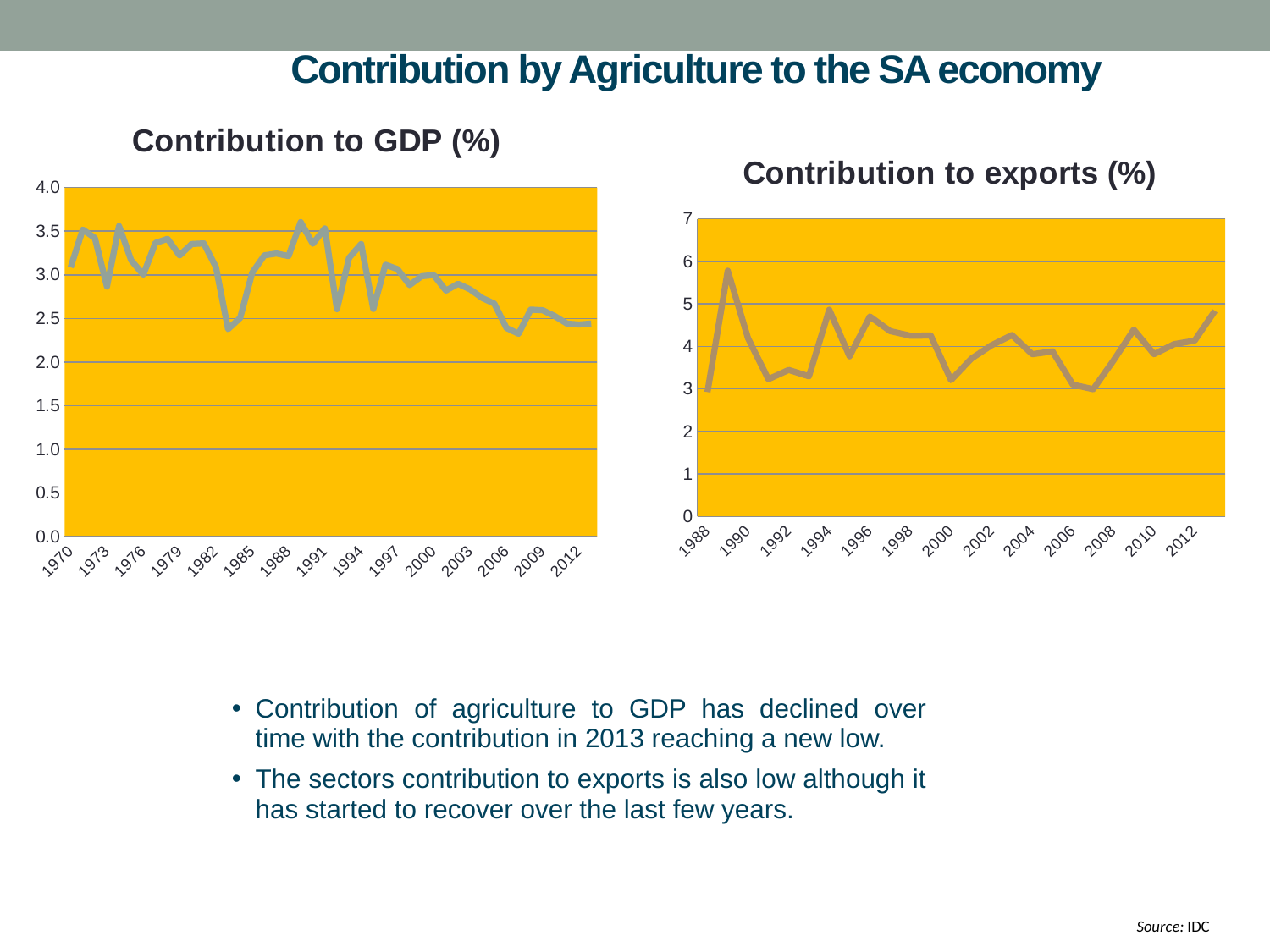
In the 'Contribution to GDP (%)' chart, is the value for 2012 greater or less than 3.0? less What is the title of the chart on the right of the slide? Contribution to exports (%) In the 'Contribution to exports (%)' chart, is the value for 2008 greater or less than 4? less In the 'Contribution to exports (%)' chart, which year has the highest value? 1989 What kind of chart is the 'Contribution to exports (%)' chart? line chart In the 'Contribution to GDP (%)' chart, do the values generally rise or fall from 1970 to 2012? fall In the 'Contribution to exports (%)' chart, is the value for 1994 greater or less than 4? greater In the 'Contribution to exports (%)' chart, which is larger, the value for 1989 or the value for 2008? 1989 What kind of chart is the 'Contribution to GDP (%)' chart? line chart